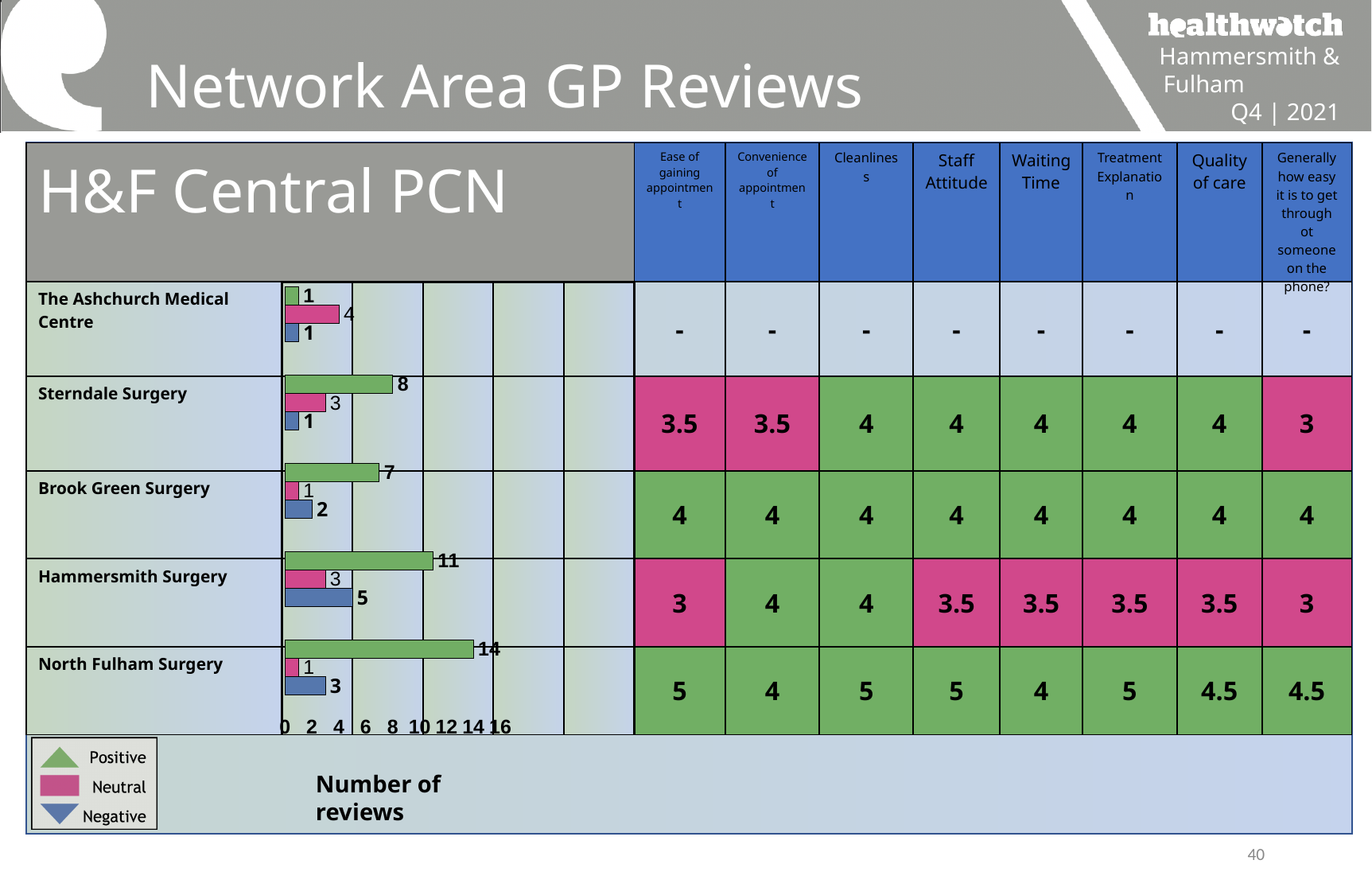
How many series does the legend of the number of reviews chart list? 3 How many negative reviews does Hammersmith Surgery have in the number of reviews chart? 5 What is the total number of reviews for Sterndale Surgery across positive, neutral and negative in the number of reviews chart? 12 Which surgery has the lowest number of positive reviews in the number of reviews chart? The Ashchurch Medical Centre Which colour represents Neutral reviews in the legend of the number of reviews chart? Pink What kind of chart shows the number of reviews on the slide? bar chart How many neutral reviews does The Ashchurch Medical Centre have in the number of reviews chart? 4 How many positive reviews does North Fulham Surgery have in the number of reviews chart? 14 What is the difference between the positive reviews for North Fulham Surgery and Hammersmith Surgery in the number of reviews chart? 3 Which has more negative reviews in the number of reviews chart, Hammersmith Surgery or Brook Green Surgery? Hammersmith Surgery How many surgeries are plotted in the number of reviews chart? 5 Which surgery has the highest number of positive reviews in the number of reviews chart? North Fulham Surgery